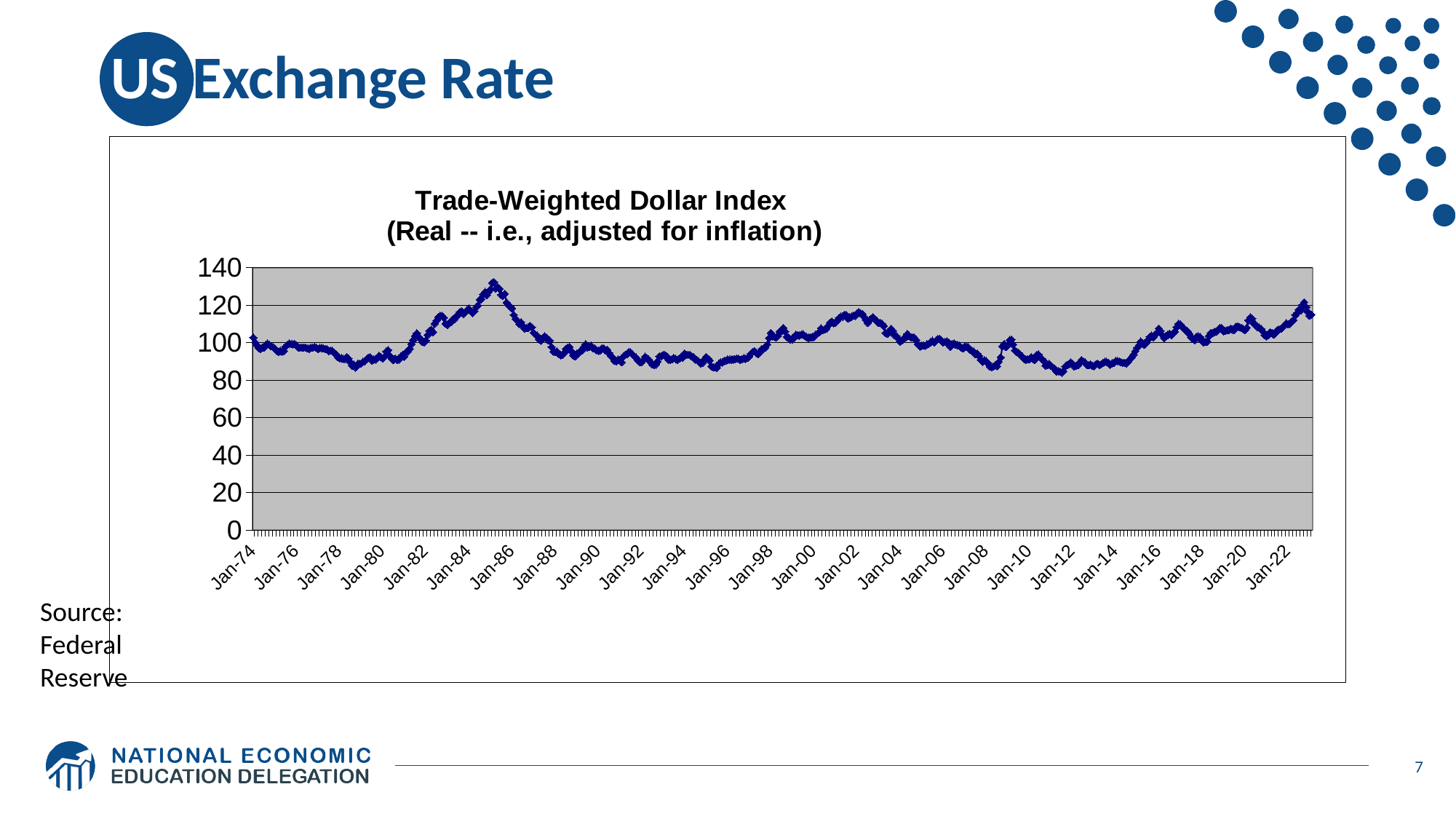
What is the title of the chart? Trade-Weighted Dollar Index (Real -- i.e., adjusted for inflation) Is the value of the index near Jan-12 greater or less than 100? less Is the value of the index near Jan-02 greater or less than 100? greater What kind of chart is shown on the slide? line chart What is the highest value shown on the vertical axis of the chart? 140 How many labels are shown on the x axis of the chart? 25 Does the index rise or fall between Jan-82 and Jan-86? rise Which is larger, the index value near Jan-86 or near Jan-12? Jan-86 Around which x-axis label does the Trade-Weighted Dollar Index reach its highest point? Jan-86 Does the index rise or fall between Jan-86 and Jan-88? fall Is the value of the index near Jan-78 greater or less than 120? less